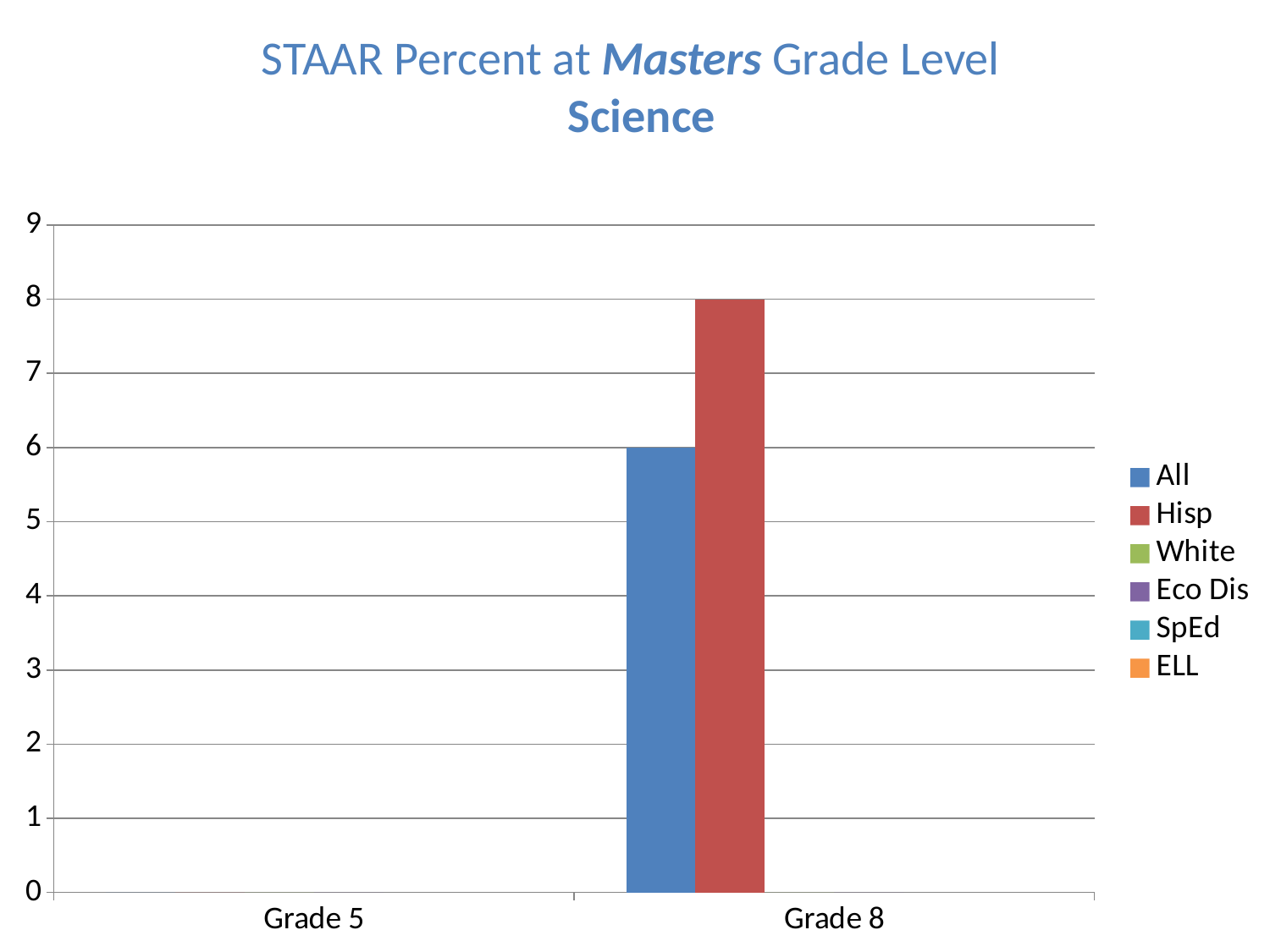
Which is larger at Grade 8, the All bar or the Hisp bar? Hisp What is the value for the All series at Grade 8? 6 How many grade categories are shown on the x axis? 2 Is the value for Hisp at Grade 8 greater or less than 7? greater How many series does the legend list? 6 Is the value for All at Grade 8 greater or less than 7? less What is the difference between the Hisp and All values at Grade 8? 2 What is the title of the chart? STAAR Percent at Masters Grade Level Science Which series has the highest value at Grade 8? Hisp What is the value for the Hisp series at Grade 8? 8 What colour is the Hisp series in the legend? red What type of chart is shown on the slide? bar chart